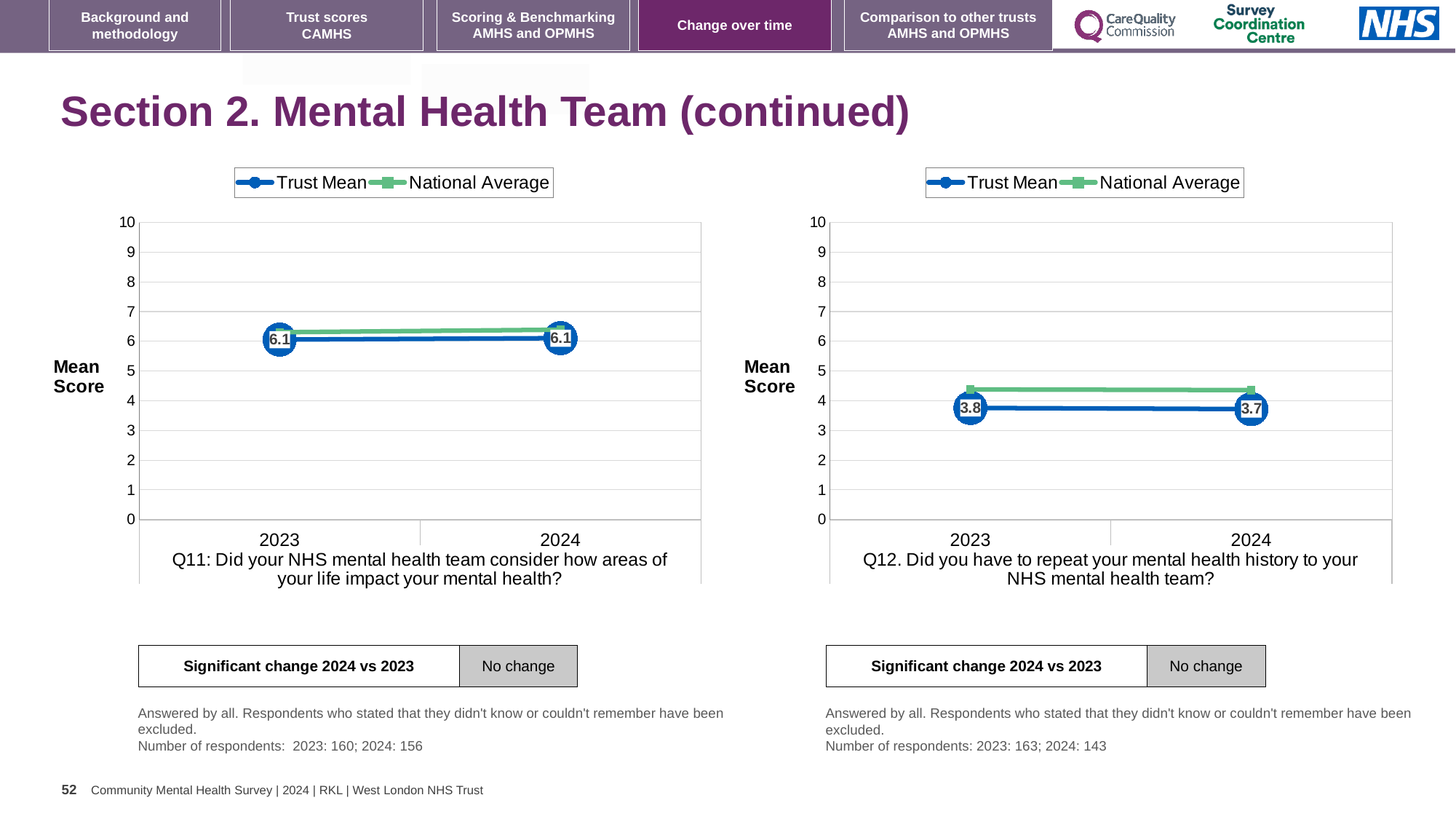
In the Q12 chart on the right, what is the Trust Mean score for 2023? 3.8 In the Q12 chart on the right, does the Trust Mean rise or fall from 2023 to 2024? Fall In the Q11 chart on the left, what is the Trust Mean score for 2024? 6.1 In the Q12 chart on the right, what is the difference between the Trust Mean scores for 2023 and 2024? 0.1 In the Q11 chart on the left, what is the Trust Mean score for 2023? 6.1 In the Q12 chart on the right, which is higher in 2024, the Trust Mean or the National Average? National Average How many years are shown on the x axis of the Q11 chart on the left? 2 In the Q12 chart on the right, what is the Trust Mean score for 2024? 3.7 What kind of chart is the Q11 chart on the left? Line chart In the Q11 chart on the left, is the National Average for 2024 greater or less than 7? less In the Q12 chart on the right, is the National Average for 2023 greater or less than 4? greater How many series does the legend of the Q12 chart on the right list? 2